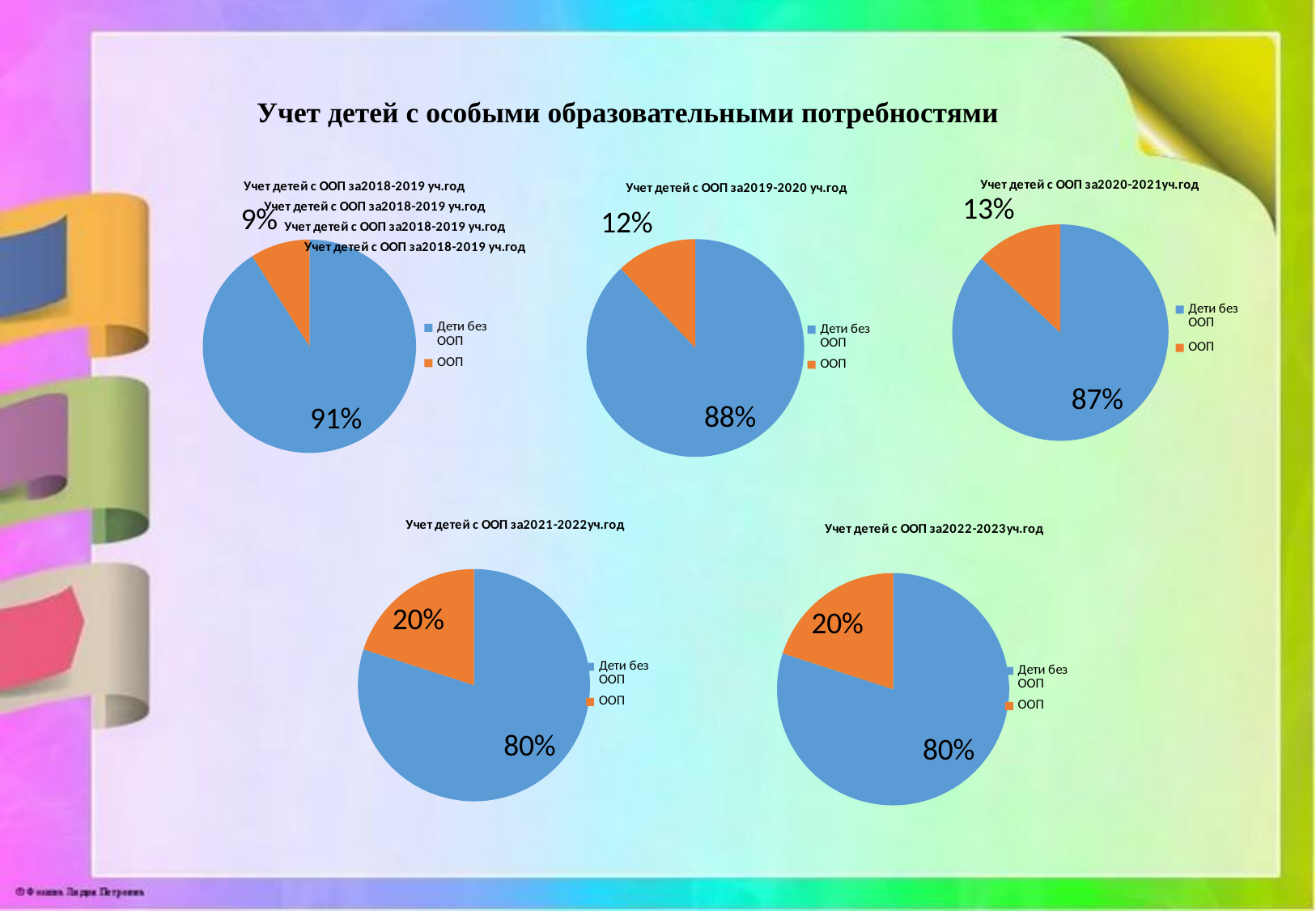
In the chart titled "Учет детей с ООП за2020-2021уч.год", what share of the pie is labelled ООП? 13% In the chart titled "Учет детей с ООП за2020-2021уч.год", what is the difference between the Дети без ООП share and the ООП share? 74% What kind of chart is the one titled "Учет детей с ООП за2022-2023уч.год"? Pie chart In the chart titled "Учет детей с ООП за2021-2022уч.год", what share of the pie is labelled ООП? 20% In the chart titled "Учет детей с ООП за2022-2023уч.год", what share of the pie is labelled Дети без ООП? 80% How many entries does the legend of the chart titled "Учет детей с ООП за2021-2022уч.год" list? 2 In the chart titled "Учет детей с ООП за2019-2020 уч.год", which slice is larger, Дети без ООП or ООП? Дети без ООП